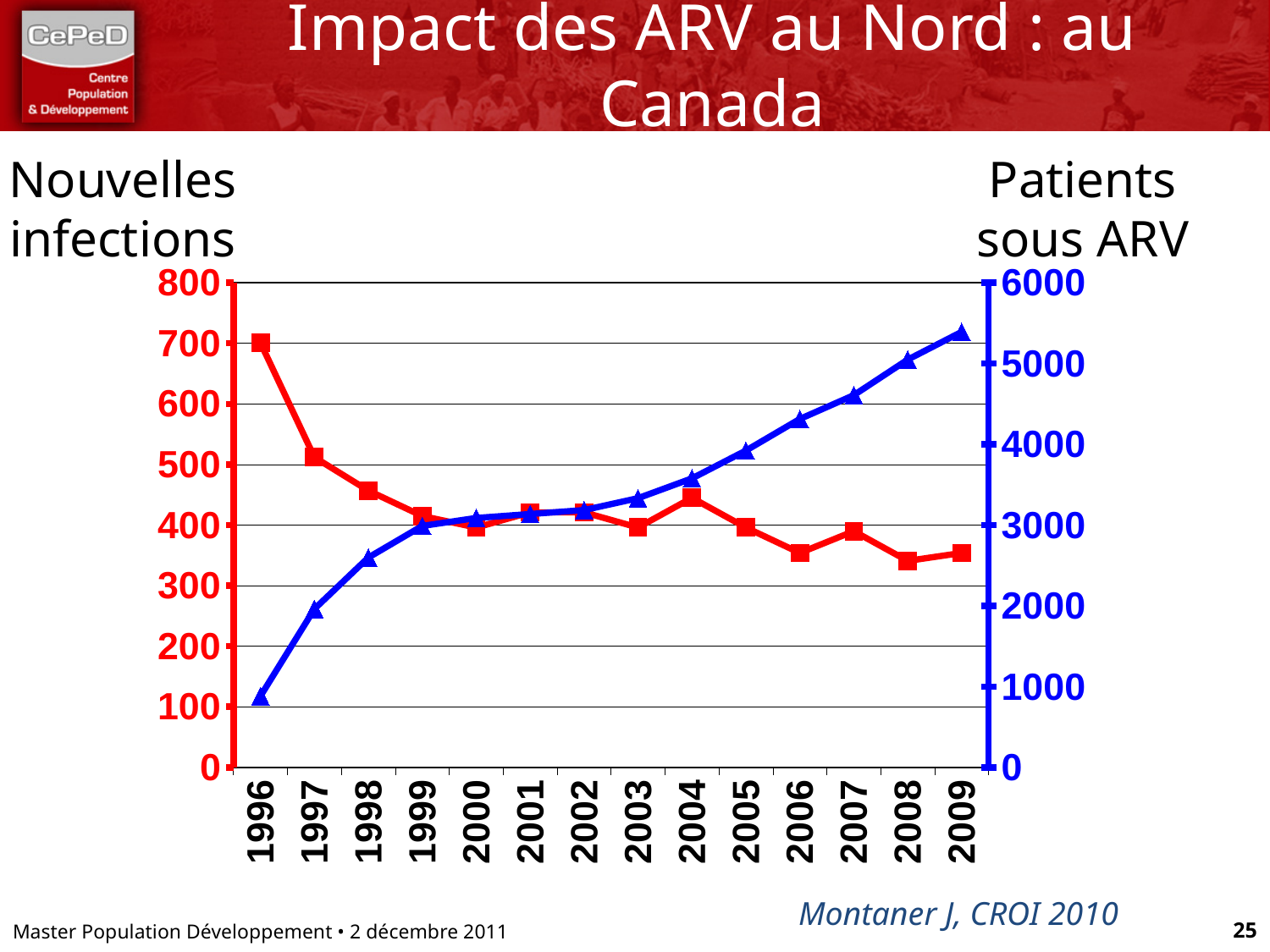
Is the 'Nouvelles infections' value for 1996 greater or less than 600? greater What kind of chart is shown on the slide? line chart In which year is the 'Nouvelles infections' value highest? 1996 Does the 'Patients sous ARV' series rise or fall from 1996 to 2009? rise In which year is the 'Patients sous ARV' value lowest? 1996 What is the title of the chart on the slide? Impact des ARV au Nord : au Canada Is the 'Patients sous ARV' value for 2009 greater or less than 5000? greater How many years are plotted along the x axis? 14 Is the 'Patients sous ARV' value for 2004 greater or less than 4000? less In which year is the 'Patients sous ARV' value highest? 2009 How many data series are plotted on the chart? 2 Does the 'Nouvelles infections' series rise or fall from 1996 to 2009? fall